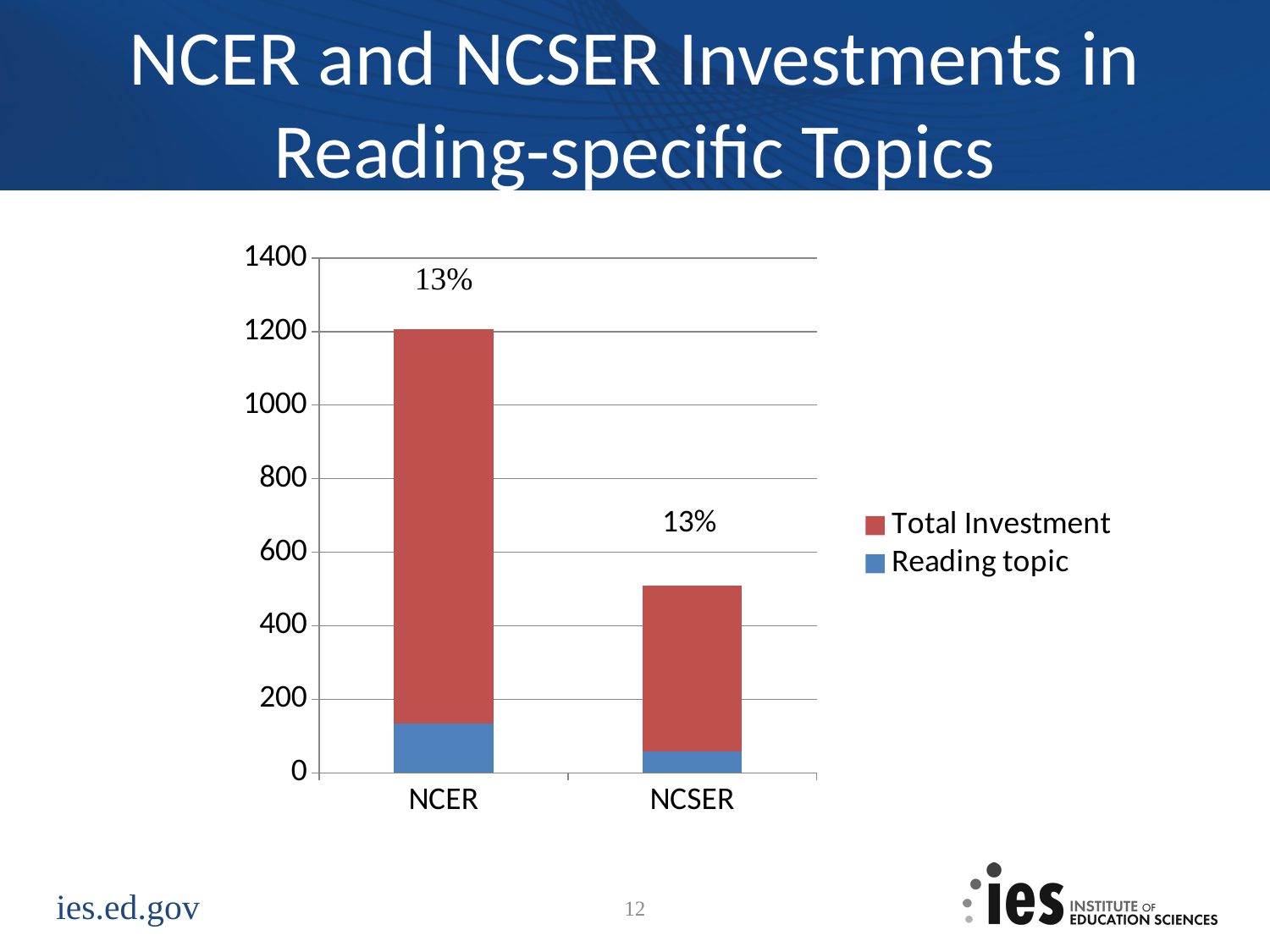
What kind of chart is shown on the slide? stacked bar chart How many series does the chart's legend list? 2 How many categories are shown on the x axis of the chart? 2 Which category has the taller stacked bar, NCER or NCSER? NCER Is the Total Investment bar for NCER larger or smaller than the Total Investment bar for NCSER? larger Which series is shown in blue in the chart's legend? Reading topic Which category has the shorter stacked bar? NCSER Is the Reading topic segment for NCER greater or less than 200? less Is the top of the NCSER stacked bar greater or less than 600? less What percentage label is printed above the NCSER bar? 13% What percentage label is printed above the NCER bar? 13% Is the top of the NCER stacked bar greater or less than 1000? greater